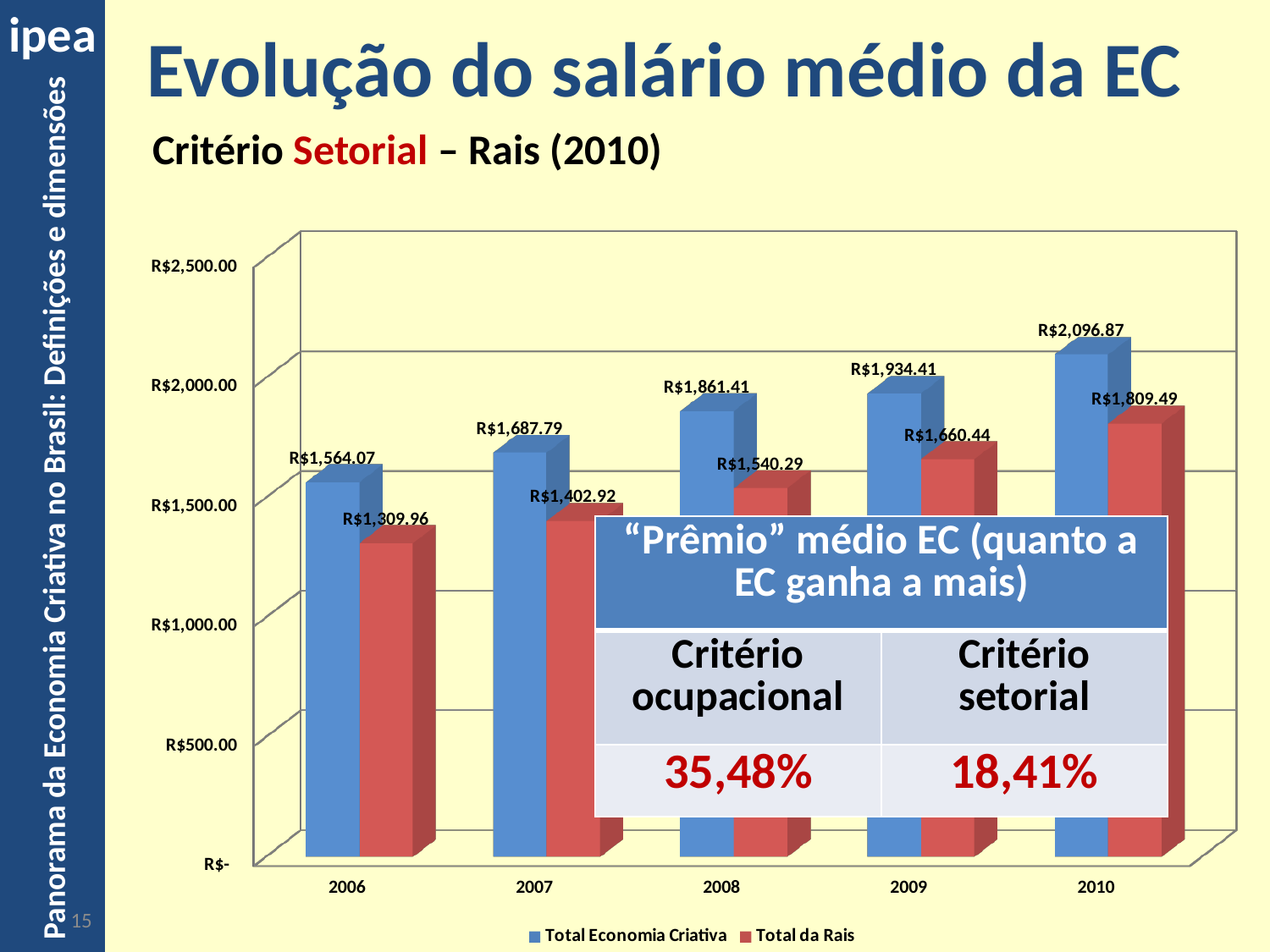
In which year is the Total Economia Criativa value highest? 2010 What is the value for Total Economia Criativa in 2010? R$2,096.87 Which is larger in 2009, Total Economia Criativa or Total da Rais? Total Economia Criativa What is the difference between Total Economia Criativa and Total da Rais in 2010? R$287.38 How many years are shown on the x axis? 5 What is the value for Total da Rais in 2008? R$1,540.29 How many series does the legend list? 2 What is the value for Total da Rais in 2006? R$1,309.96 In which year is the Total da Rais value lowest? 2006 Is the value for Total da Rais in 2010 greater or less than R$2,000.00? less What is the value for Total Economia Criativa in 2007? R$1,687.79 Do the Total Economia Criativa values rise or fall from 2006 to 2010? rise